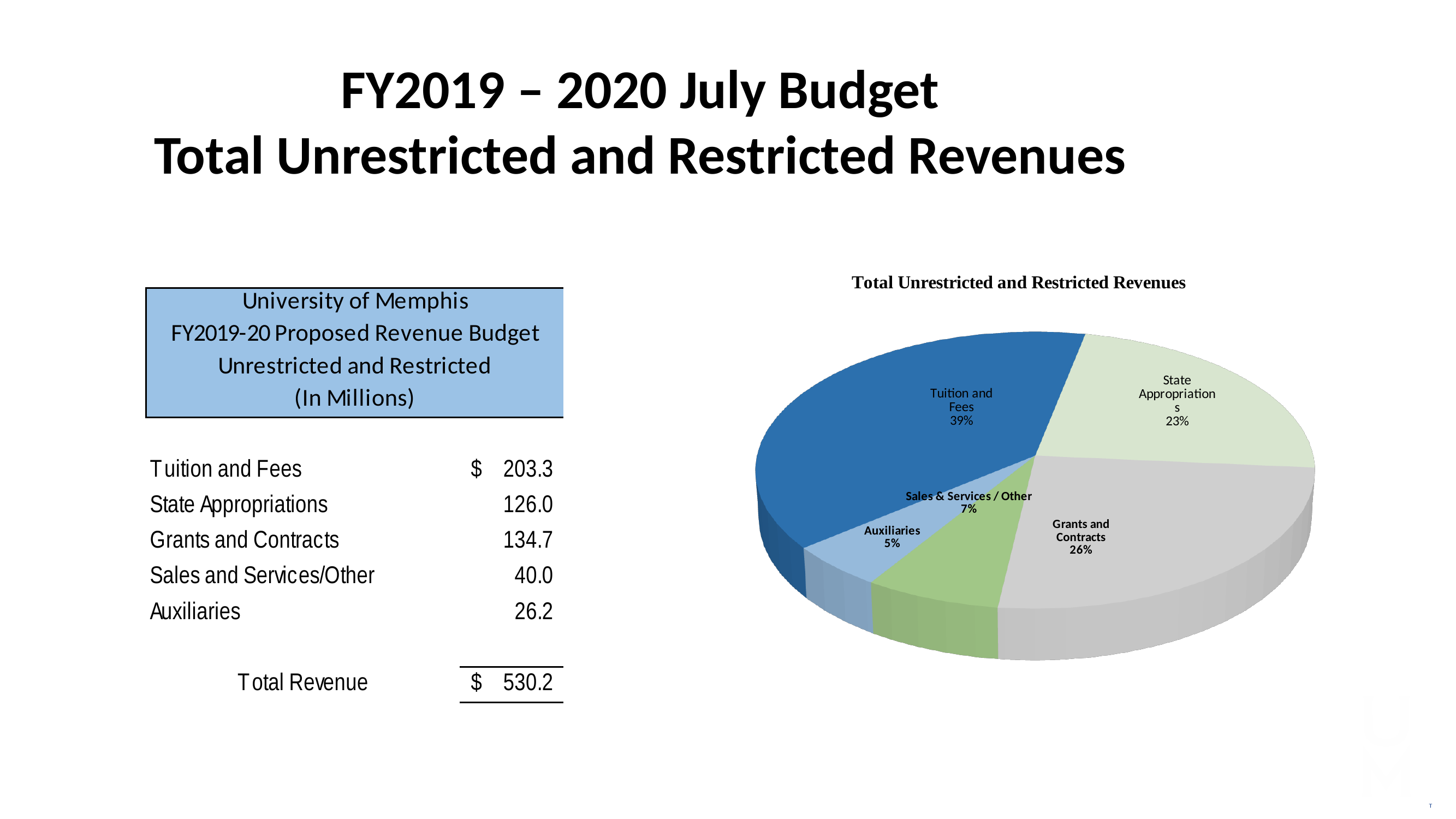
What share of the pie chart does Auxiliaries represent? 5% What is the title of the pie chart? Total Unrestricted and Restricted Revenues Which is larger in the pie chart, Grants and Contracts or State Appropriations? Grants and Contracts What share of the pie chart does Sales & Services / Other represent? 7% What share of the pie chart does State Appropriations represent? 23% Which slice of the pie chart is the smallest? Auxiliaries What is the difference in percentage points between the Tuition and Fees slice and the Grants and Contracts slice? 13% Which slice of the pie chart is the largest? Tuition and Fees What kind of chart is shown on the slide? Pie chart How many slices does the pie chart have? 5